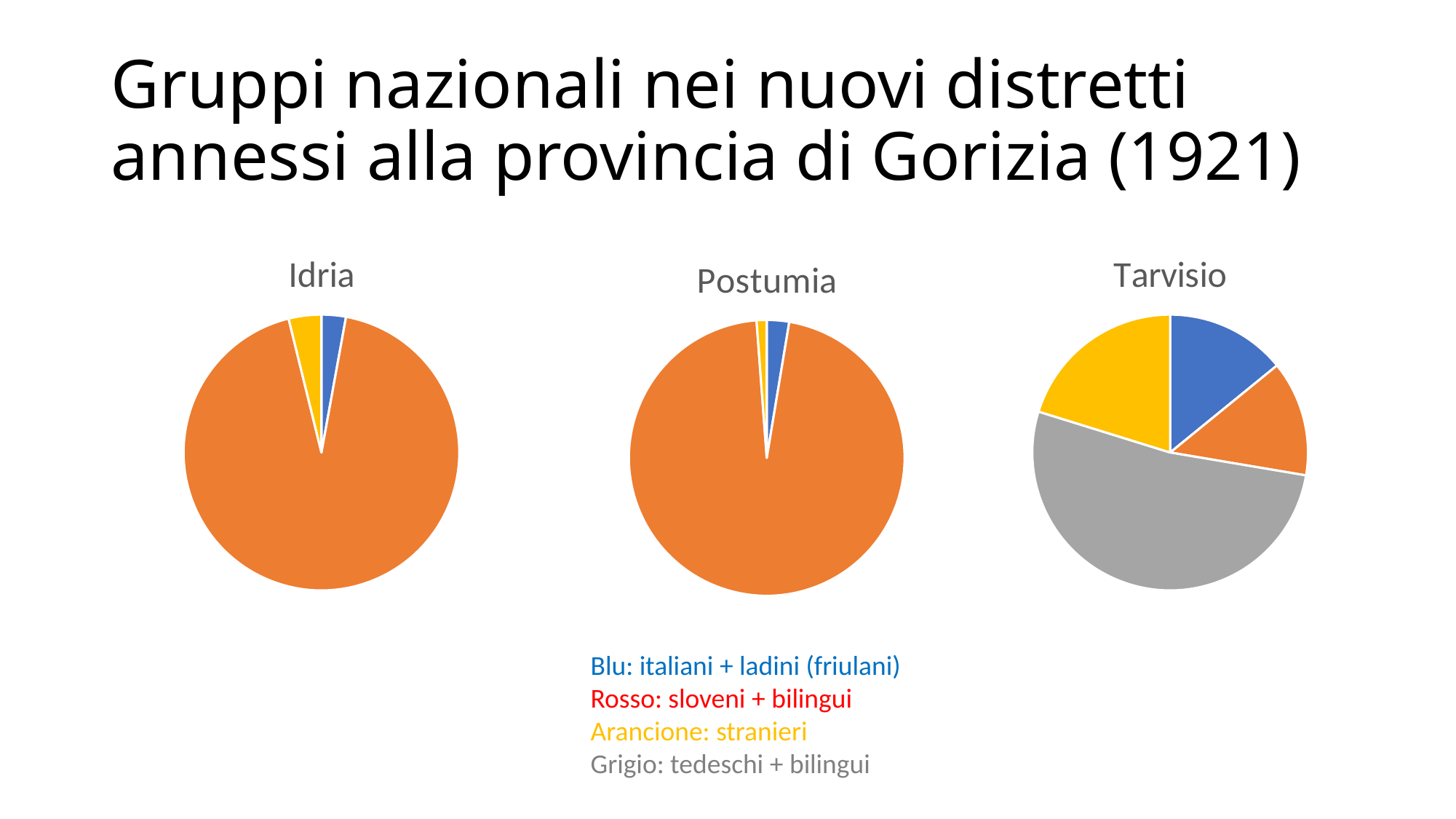
In the Tarvisio pie chart, which colour slice is the largest? Grey According to the legend text, what group does the blue colour represent? italiani + ladini (friulani) How many pie charts are on the slide? 3 Which of the three pie charts contains a grey slice? Tarvisio How many slices does the Tarvisio pie chart have? 4 How many slices does the Postumia pie chart have? 3 In the Tarvisio pie chart, which is larger, the blue slice or the yellow slice? Yellow In the Postumia pie chart, which colour slice is the largest? Orange What kind of charts are shown on the slide? Pie charts In the Idria pie chart, which colour slice is the largest? Orange